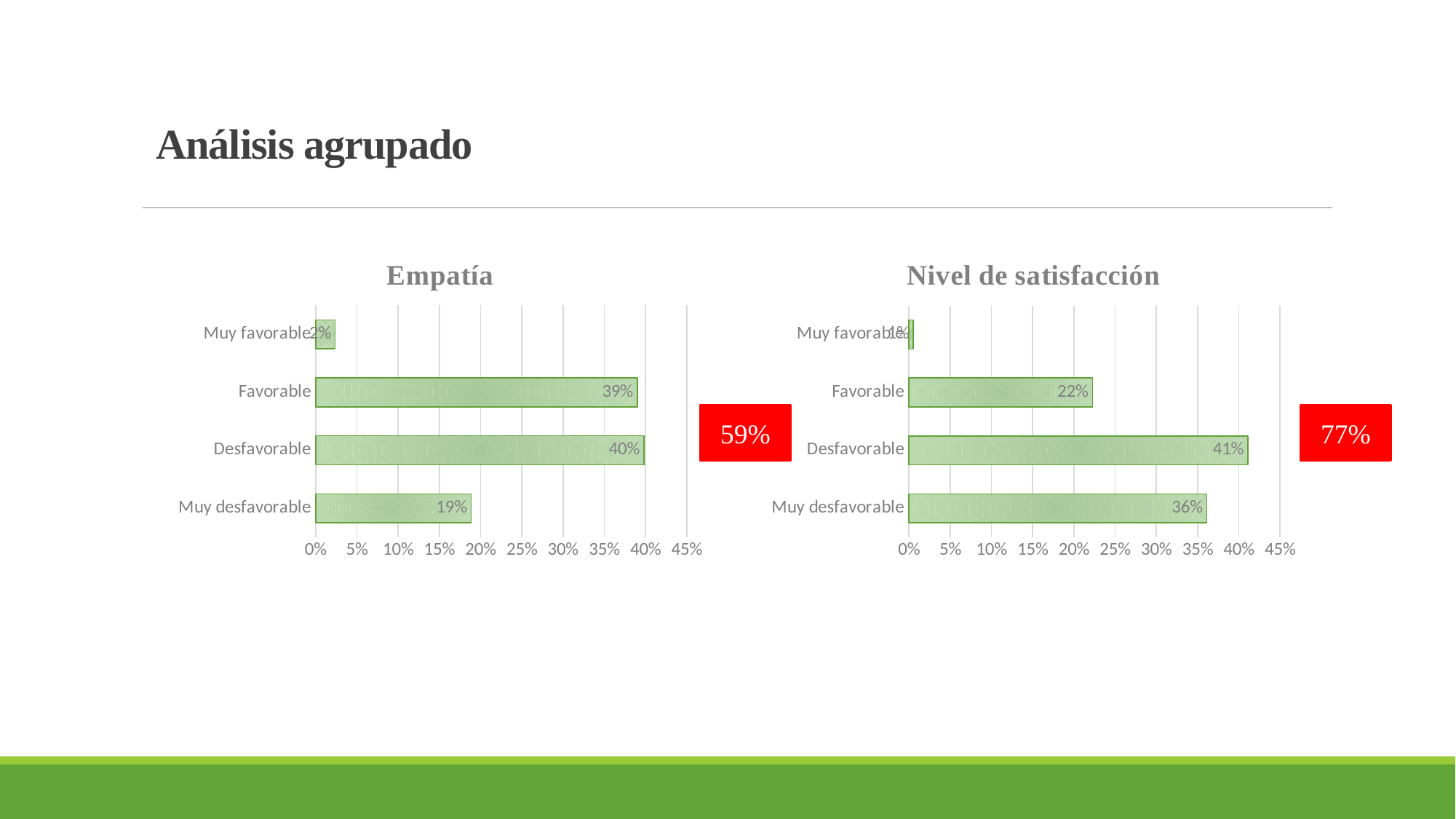
What kind of chart is the Nivel de satisfacción chart? Bar chart How many categories does the Empatía chart show? 4 In the Empatía chart, is the value for Favorable greater or less than 35%? greater In the Nivel de satisfacción chart, what is the value for Muy desfavorable? 36% In the Nivel de satisfacción chart, what is the difference between Desfavorable and Favorable? 19% In the Nivel de satisfacción chart, what is the value for Favorable? 22% In the Nivel de satisfacción chart, which is larger, Muy desfavorable or Favorable? Muy desfavorable In the Empatía chart, what is the value for Muy desfavorable? 19% In the Empatía chart, which category has the lowest value? Muy favorable In the Empatía chart, what is the difference between Favorable and Muy desfavorable? 20% In the Nivel de satisfacción chart, which category has the highest value? Desfavorable In the Empatía chart, what is the value for Desfavorable? 40%